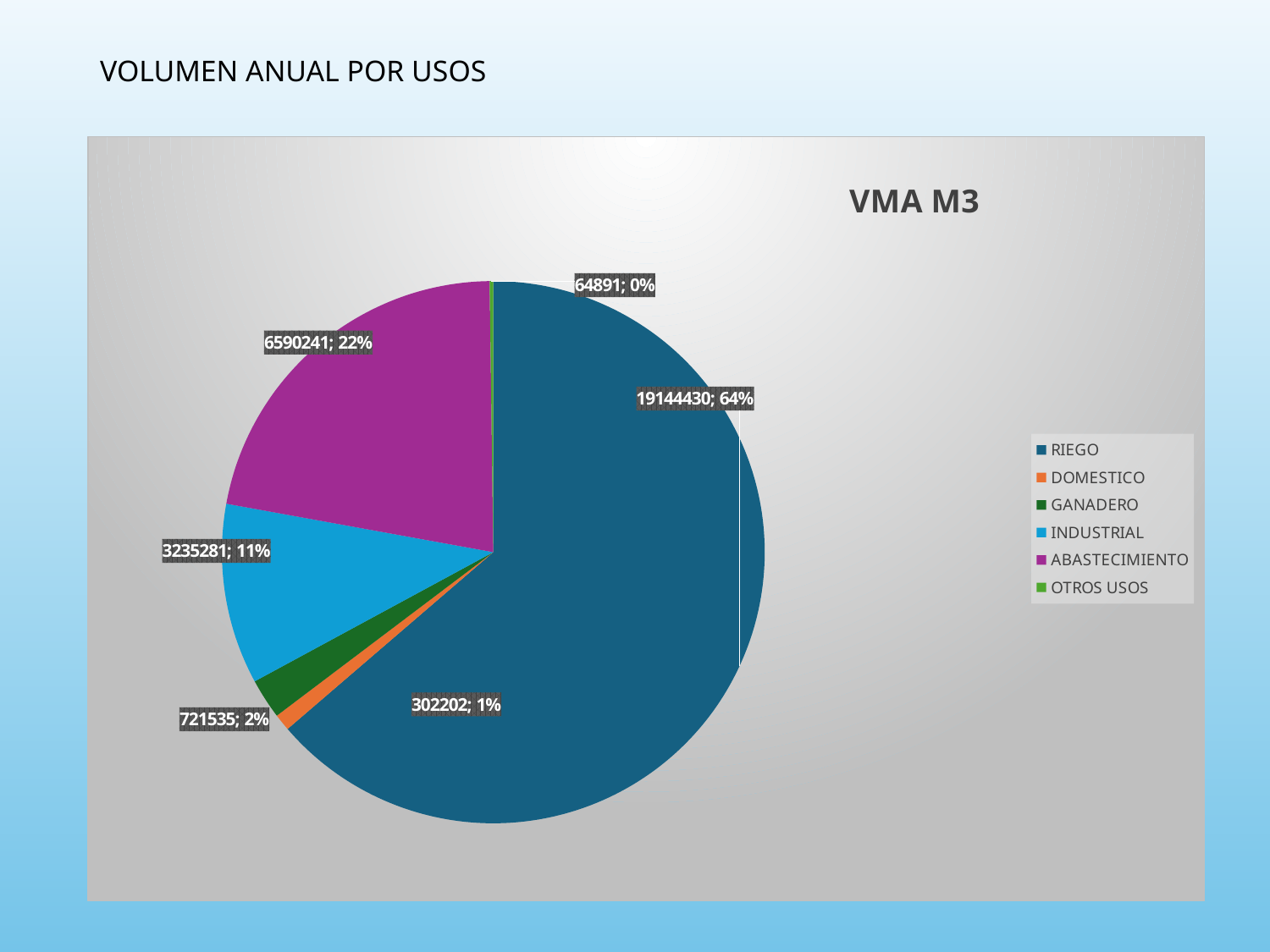
What is the value for GANADERO in the pie chart? 721535 What kind of chart is shown on the slide? pie chart What is the value for INDUSTRIAL in the pie chart? 3235281 What is the title of the pie chart? VMA M3 Which category has the smallest slice in the pie chart? OTROS USOS What share of the pie does INDUSTRIAL represent? 11% What share of the pie does RIEGO represent? 64% What is the value for RIEGO in the pie chart? 19144430 Which category has the largest slice in the pie chart? RIEGO How many categories does the legend of the pie chart list? 6 What is the value for ABASTECIMIENTO in the pie chart? 6590241 What is the value for OTROS USOS in the pie chart? 64891